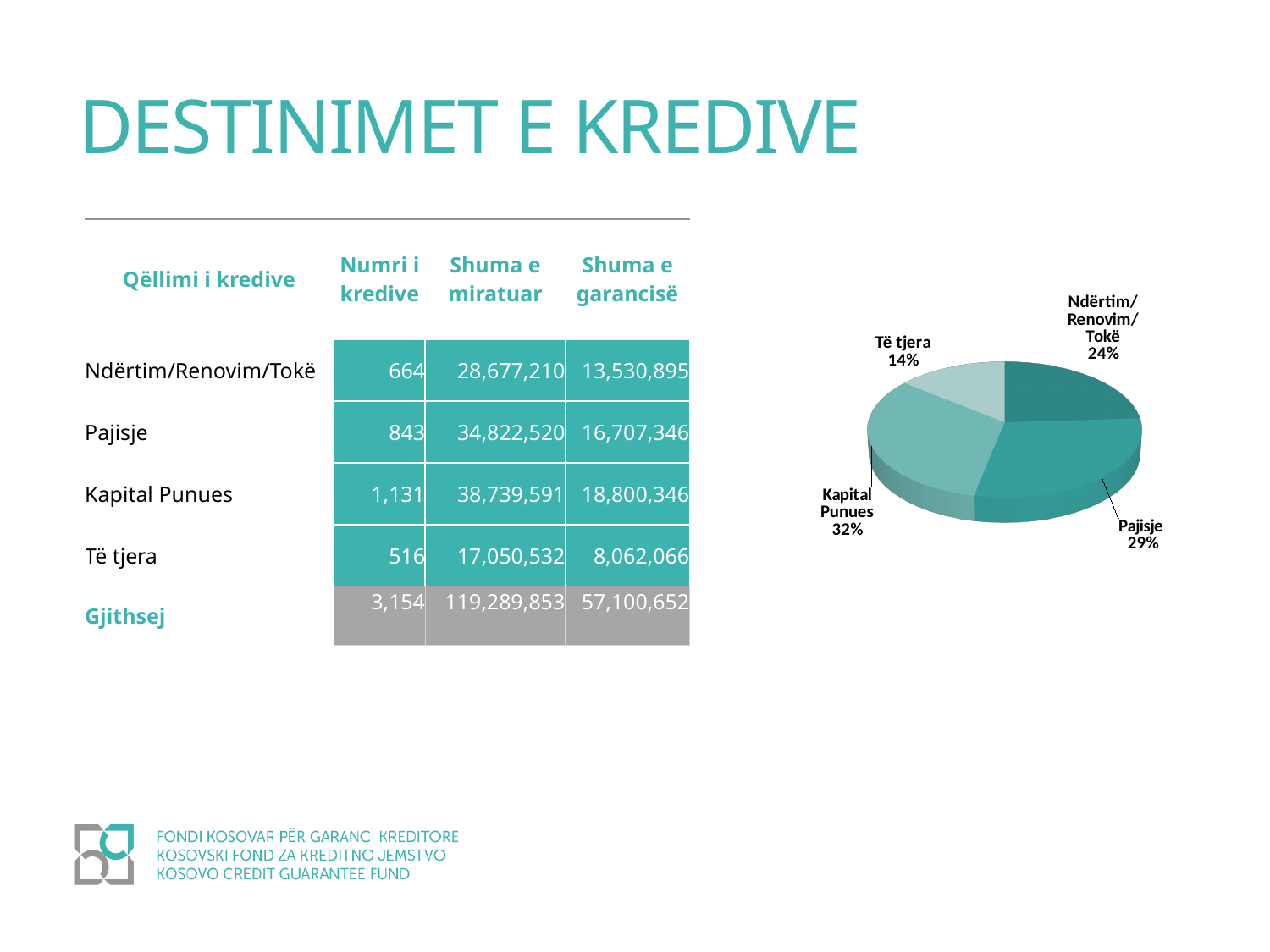
In the pie chart, what is the difference in percentage points between Kapital Punues and Të tjera? 18 What share of the pie chart does Të tjera represent? 14% How many slices does the pie chart have? 4 Which slice of the pie chart is labelled at the top right? Ndërtim/Renovim/Tokë Which slice of the pie chart is the largest? Kapital Punues In the pie chart, which is larger: Pajisje or Ndërtim/Renovim/Tokë? Pajisje What share of the pie chart does Pajisje represent? 29% Which slice of the pie chart is the smallest? Të tjera What kind of chart is shown on the slide? pie chart What share of the pie chart does Ndërtim/Renovim/Tokë represent? 24% In the pie chart, what is the difference in percentage points between Pajisje and Ndërtim/Renovim/Tokë? 5